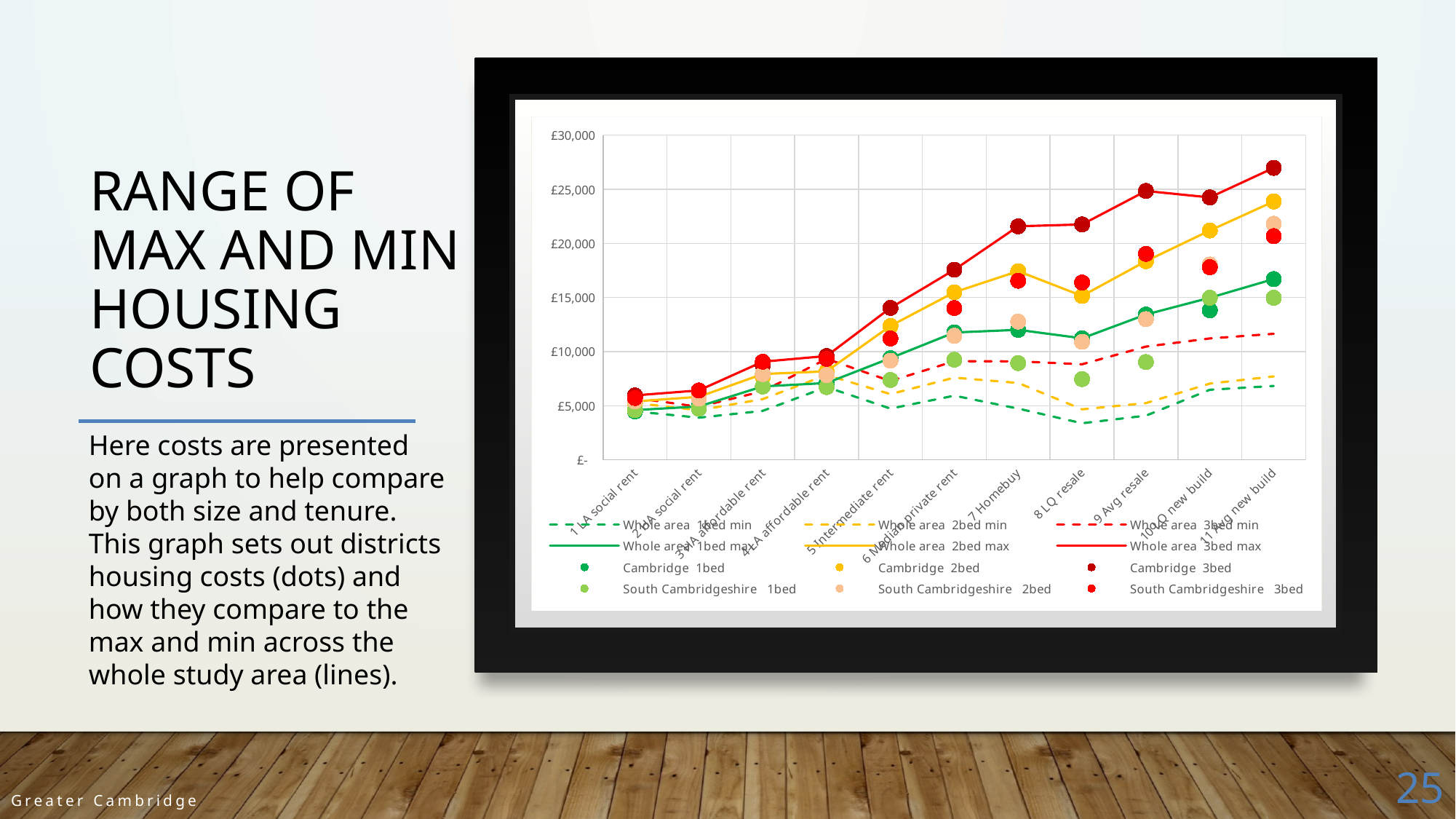
For which category is the Whole area 3bed max line lowest? 1 LA social rent What kind of chart is shown on the slide? line chart What colour are the 3bed series in the legend? red At 11 Avg new build, which is higher: Cambridge 3bed or South Cambridgeshire 3bed? Cambridge 3bed How many series does the legend list? 12 Is the value for Cambridge 3bed at 7 Homebuy greater or less than £20,000? greater Is the value for Whole area 1bed min at 8 LQ resale greater or less than £5,000? less For which category is the Whole area 3bed max line highest? 11 Avg new build Is the value for Cambridge 3bed at 11 Avg new build greater or less than £25,000? greater Does the Whole area 3bed max line generally rise or fall from 1 LA social rent to 11 Avg new build? rise How many tenure categories are shown along the x axis? 11